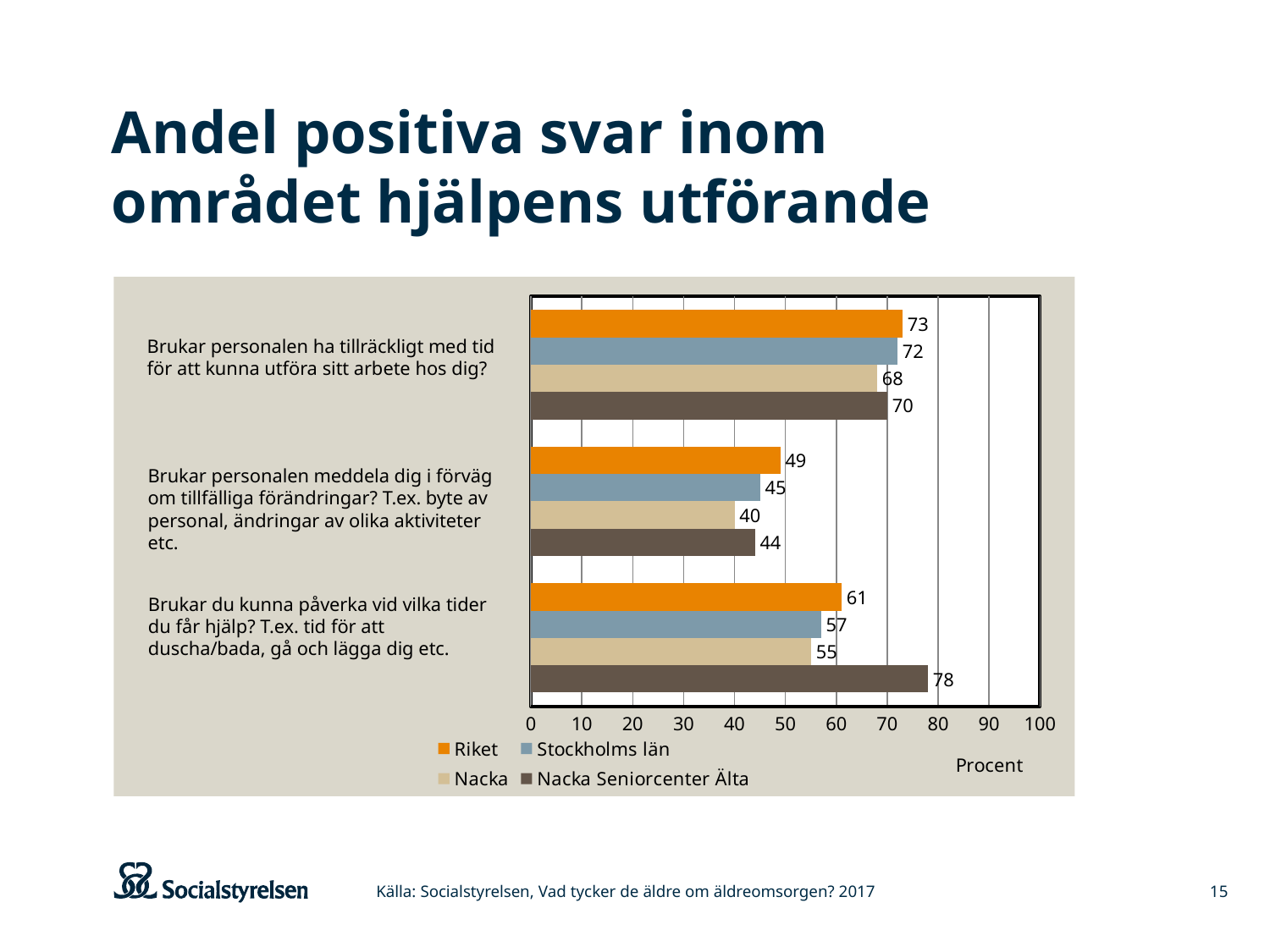
What is the difference between Riket and Nacka on the question "Brukar personalen ha tillräckligt med tid för att kunna utföra sitt arbete hos dig?"? 5 Which is larger on the question "Brukar personalen meddela dig i förväg om tillfälliga förändringar?": Riket or Nacka Seniorcenter Älta? Riket Which series has the highest value on the question "Brukar du kunna påverka vid vilka tider du får hjälp?"? Nacka Seniorcenter Älta What is the value for Nacka on the question "Brukar personalen meddela dig i förväg om tillfälliga förändringar?"? 40 Which series has the lowest value on the question "Brukar personalen meddela dig i förväg om tillfälliga förändringar?"? Nacka How many series does the legend list? 4 What is the value for Nacka Seniorcenter Älta on the question "Brukar du kunna påverka vid vilka tider du får hjälp?"? 78 How many questions (categories) are shown on the chart? 3 What is the value for Stockholms län on the question "Brukar du kunna påverka vid vilka tider du får hjälp?"? 57 What kind of chart is shown on the slide? Bar chart What is the value for Riket on the question "Brukar personalen ha tillräckligt med tid för att kunna utföra sitt arbete hos dig?"? 73 What is the label on the horizontal axis of the chart? Procent